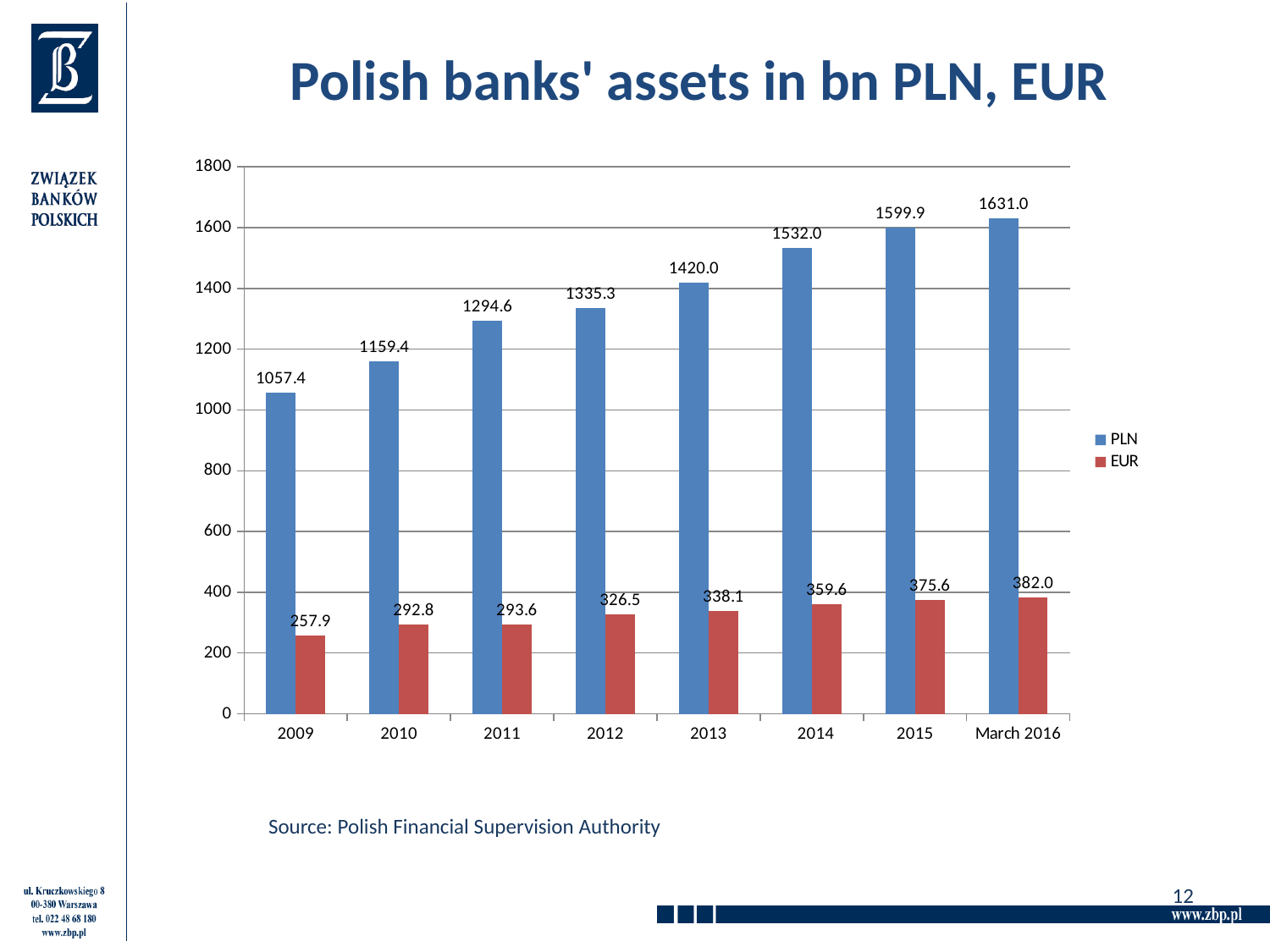
What is the PLN value for 2009? 1057.4 How many series does the legend list? 2 Is the PLN value for 2012 greater or less than 1400? less Which is larger, the EUR value for 2011 or the EUR value for 2012? 2012 What is the PLN value for 2013? 1420.0 Which category has the lowest EUR value? 2009 How many categories are shown on the x axis? 8 What kind of chart is shown on the slide? bar chart What is the EUR value for March 2016? 382.0 Which category has the highest PLN value? March 2016 What is the difference between the PLN values for 2015 and 2014? 67.9 Do the PLN values rise or fall from 2009 to March 2016? rise